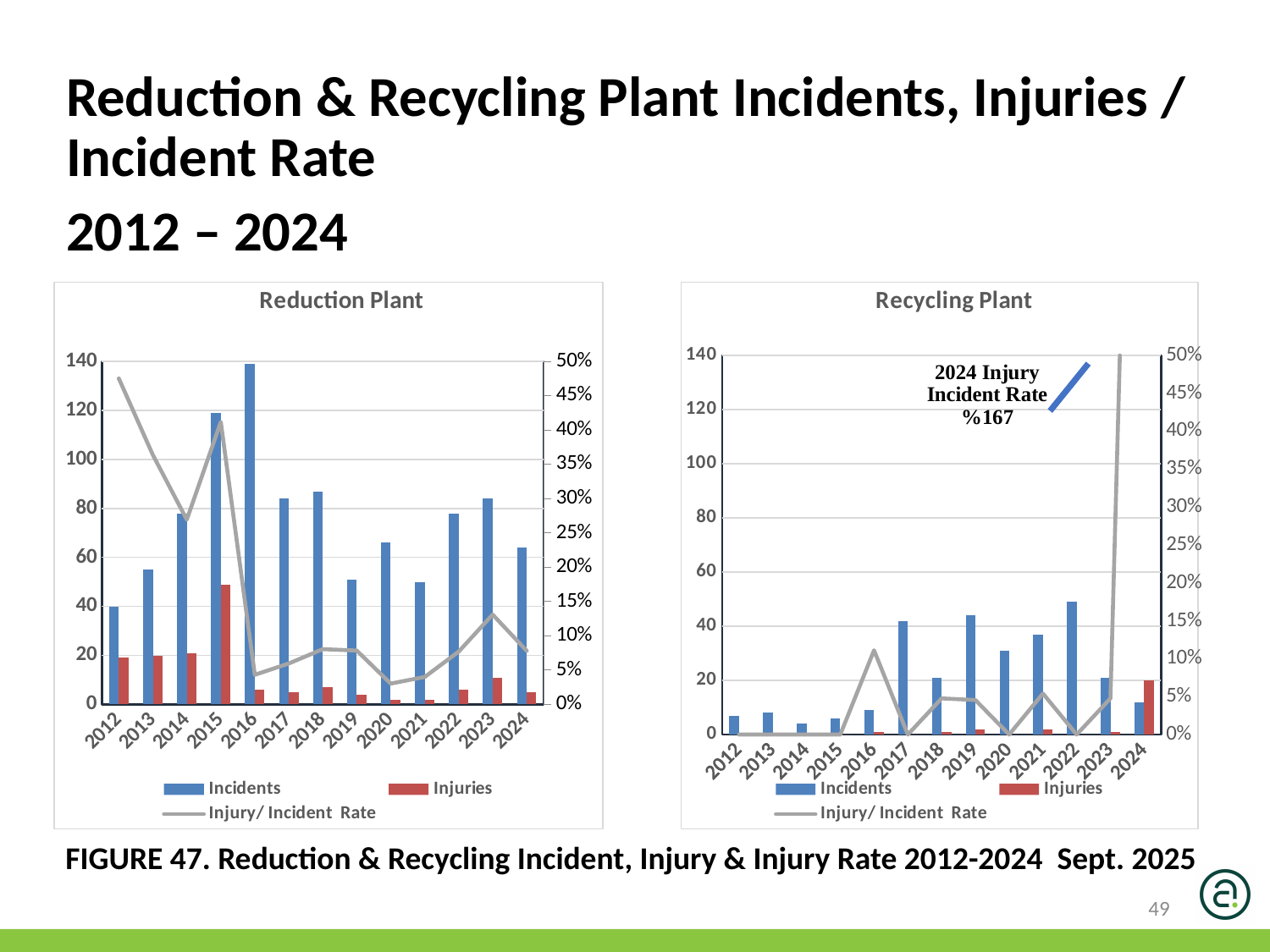
How many series does the legend of the Recycling Plant chart list? 3 In the Recycling Plant chart, which year has more Incidents, 2017 or 2018? 2017 In the Recycling Plant chart, which year has the highest number of Injuries? 2024 In the Reduction Plant chart, which year has the lowest number of Incidents? 2012 What kind of chart is the Reduction Plant chart? bar and line chart In the Reduction Plant chart, which year has the highest number of Injuries? 2015 In the Recycling Plant chart, which year has the highest number of Incidents? 2022 In the Recycling Plant chart, what 2024 Injury Incident Rate is printed in the annotation? %167 In the Reduction Plant chart, is the Incidents value for 2012 greater or less than 60? less In the Reduction Plant chart, is the Incidents value for 2016 greater or less than 120? greater How many years are shown on the x axis of the Reduction Plant chart? 13